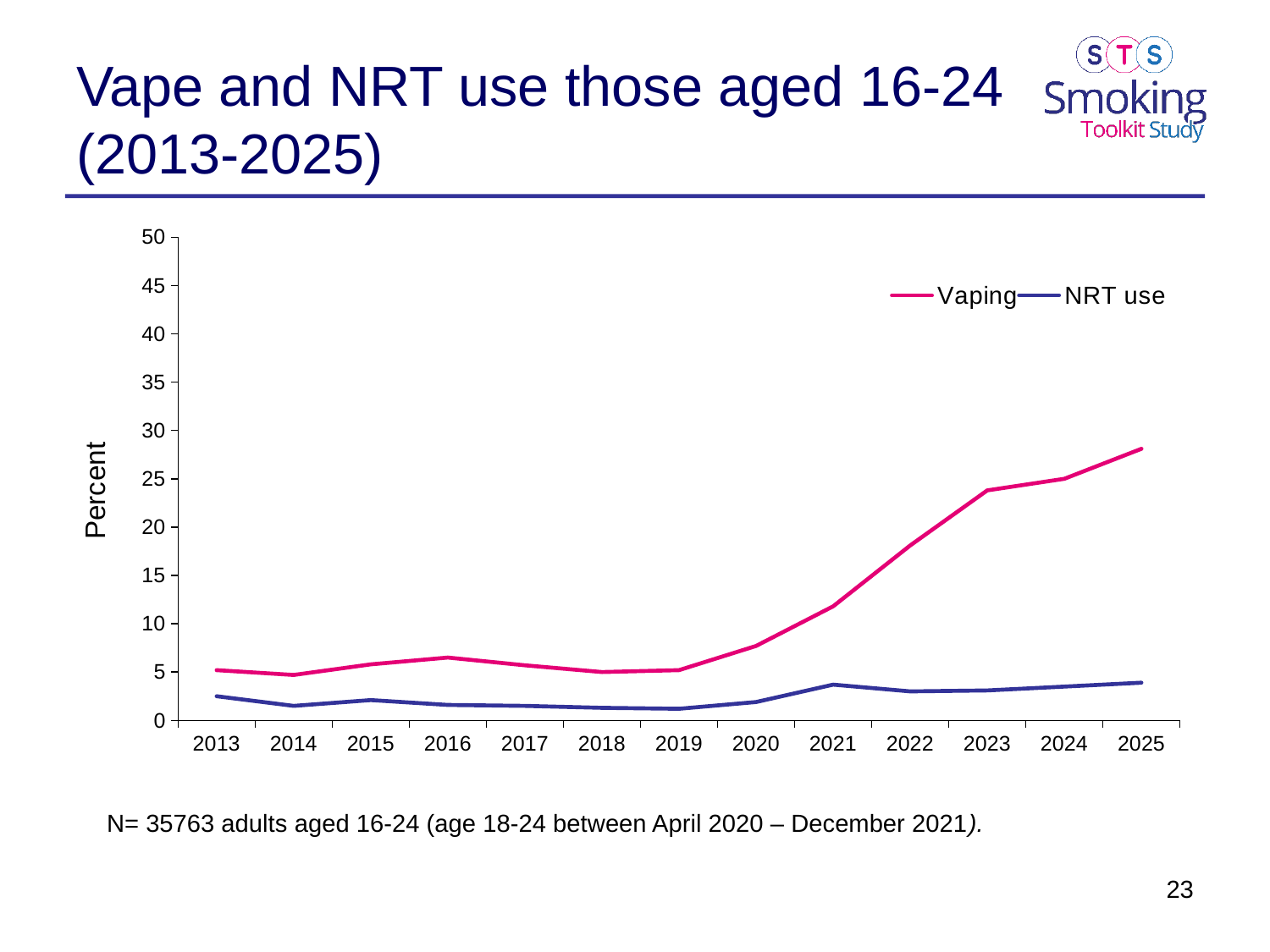
What is the label on the y axis? Percent How many series does the legend list? 2 How many years are shown along the x axis? 13 Is the value for NRT use in 2021 greater or less than 5? less Is the value for Vaping in 2023 greater or less than 20? greater Does the Vaping series rise or fall between 2019 and 2025? Rise In which year is the Vaping series at its highest? 2025 Which series is drawn in pink? Vaping What kind of chart is shown on the slide? Line chart Is the value for Vaping in 2019 greater or less than 10? less Which series has the higher value in 2025, Vaping or NRT use? Vaping